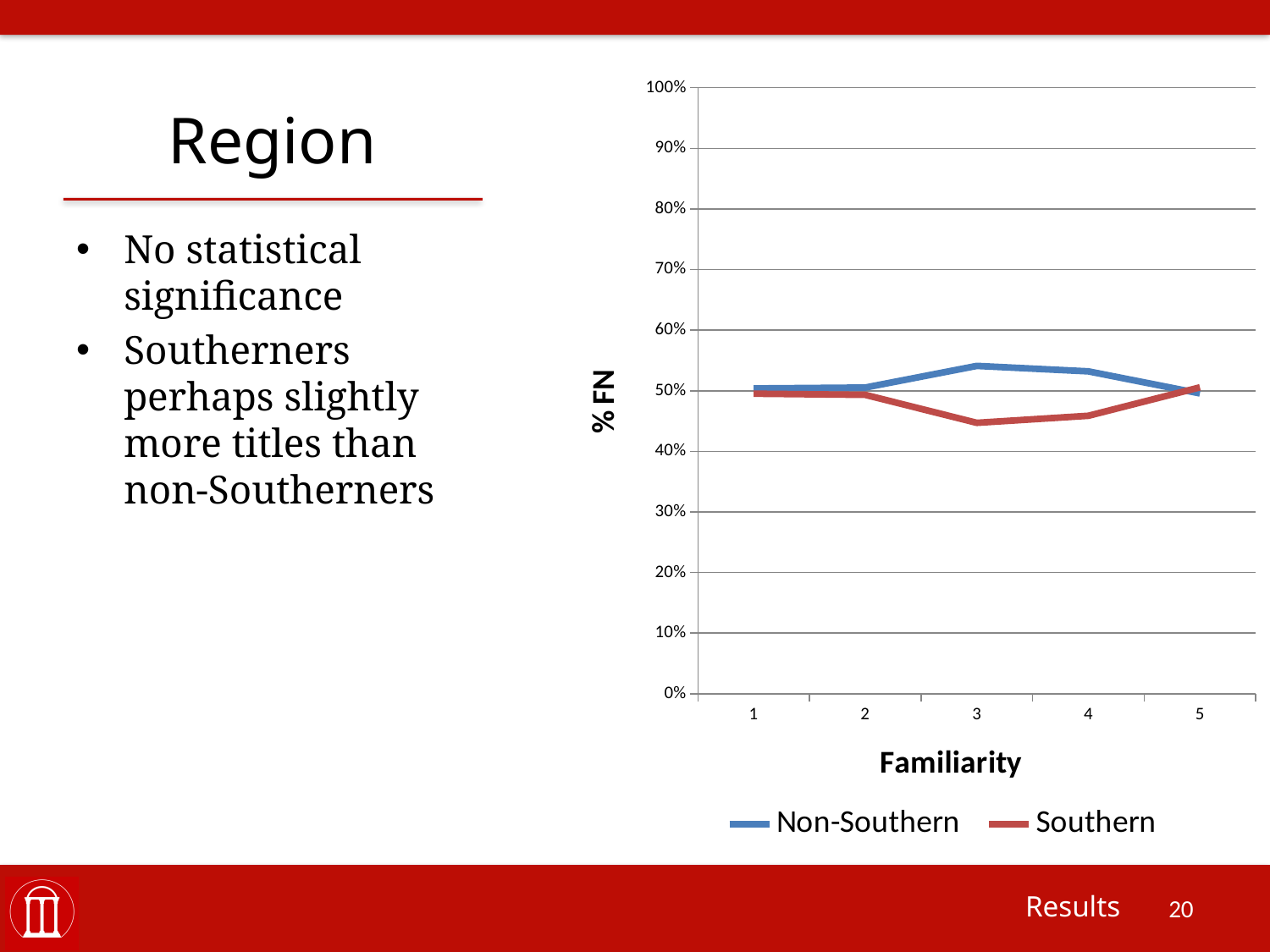
Is the value for Non-Southern at Familiarity 3 greater or less than 50%? greater At which Familiarity level does the Non-Southern series reach its highest value? 3 Is the value for Southern at Familiarity 3 greater or less than 50%? less At Familiarity 3, which series has the higher % FN, Non-Southern or Southern? Non-Southern Does the Southern series rise or fall from Familiarity 2 to Familiarity 3? fall What is the label on the y axis of the chart? % FN At which Familiarity level does the Southern series reach its lowest value? 3 Is the value for Southern at Familiarity 4 greater or less than 50%? less How many Familiarity levels are plotted along the x axis? 5 At Familiarity 4, which series has the higher % FN, Non-Southern or Southern? Non-Southern What kind of chart is shown on the slide? line chart How many series does the legend list? 2